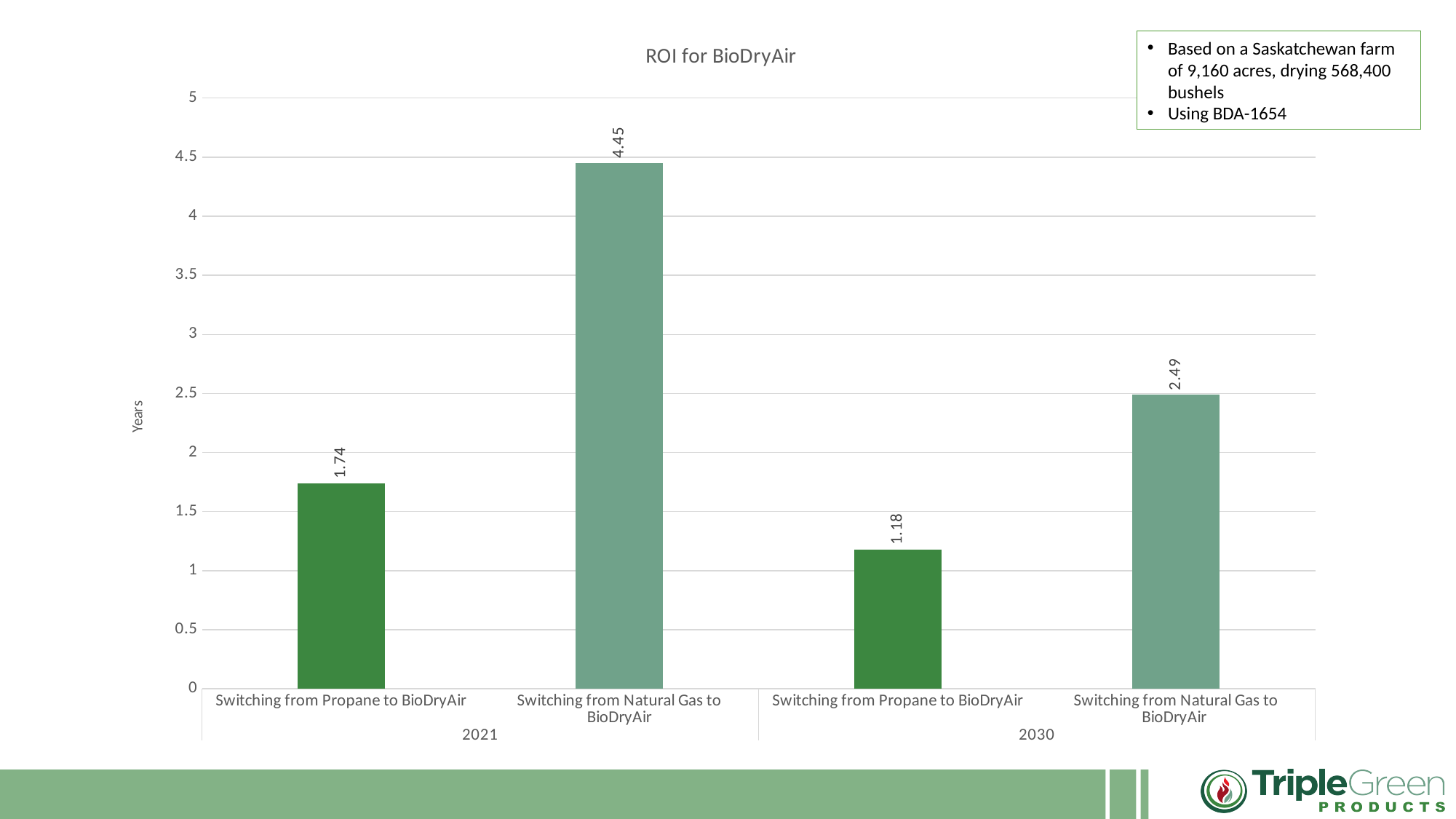
How many bars are plotted in the chart? 4 What is the difference between the 2021 and 2030 values for switching from Propane to BioDryAir? 0.56 What is the ROI in years for switching from Propane to BioDryAir in 2030? 1.18 What is the ROI in years for switching from Propane to BioDryAir in 2021? 1.74 Which is larger: the 2021 value for switching from Propane to BioDryAir or the 2030 value for switching from Natural Gas to BioDryAir? 2030 Switching from Natural Gas to BioDryAir Which bar has the lowest value? Switching from Propane to BioDryAir, 2030 What type of chart is shown? Bar chart What is the ROI in years for switching from Natural Gas to BioDryAir in 2021? 4.45 What is the difference between the 2021 and 2030 values for switching from Natural Gas to BioDryAir? 1.96 What is the title of the chart? ROI for BioDryAir What is the ROI in years for switching from Natural Gas to BioDryAir in 2030? 2.49 Which bar has the highest value? Switching from Natural Gas to BioDryAir, 2021